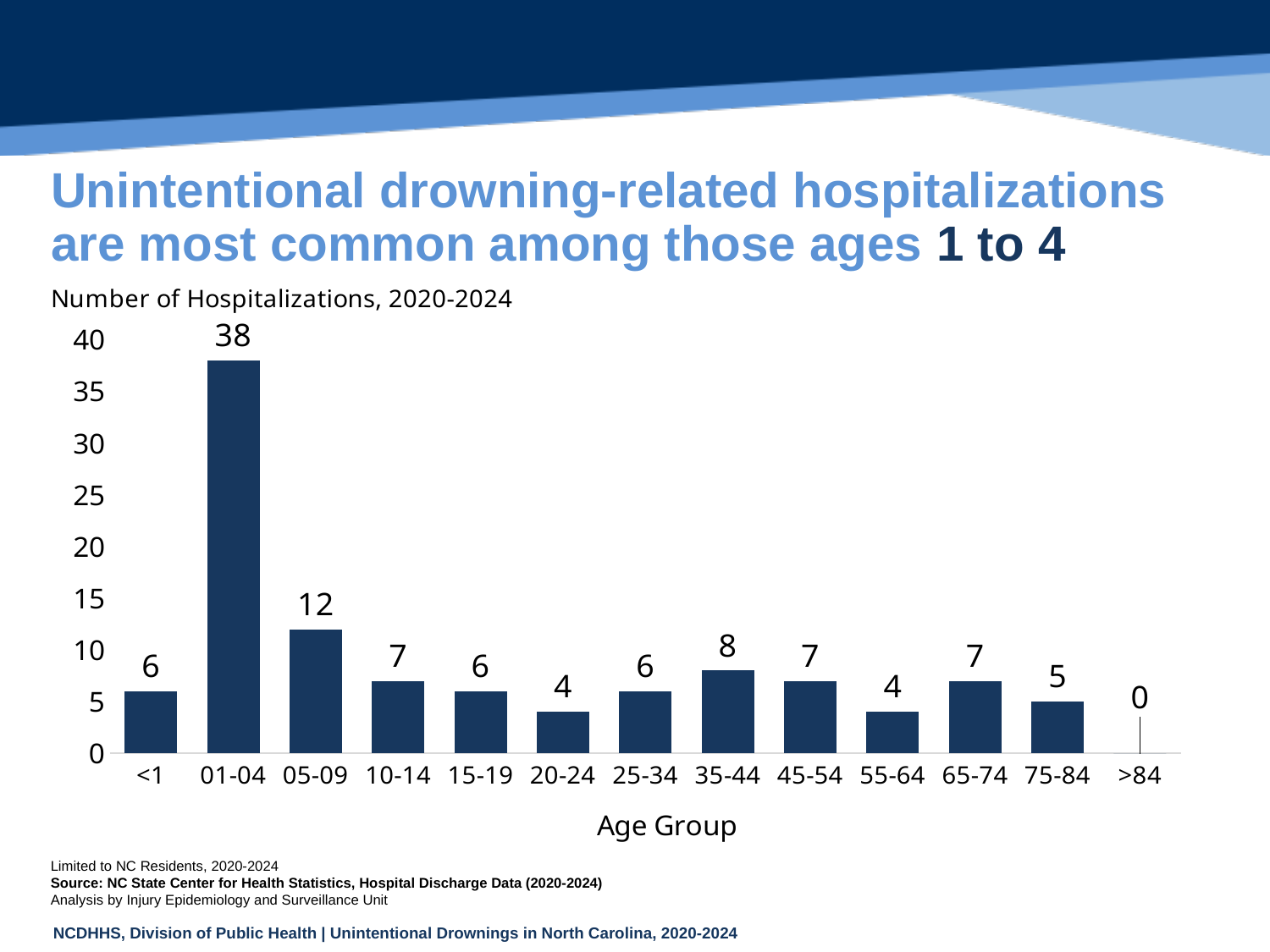
How many age groups are shown on the x axis? 13 What is the label of the x axis? Age Group Which age group has more hospitalizations, 35-44 or 55-64? 35-44 What kind of chart is shown on the slide? Bar chart What is the number of hospitalizations for the >84 age group? 0 What is the number of hospitalizations for the 01-04 age group? 38 Is the value for the 01-04 age group greater or less than 35? greater Which age group has the lowest number of hospitalizations? >84 What is the difference in hospitalizations between the 01-04 and 05-09 age groups? 26 Which age group has the highest number of hospitalizations? 01-04 What is the title of the chart? Number of Hospitalizations, 2020-2024 What is the number of hospitalizations for the 05-09 age group? 12